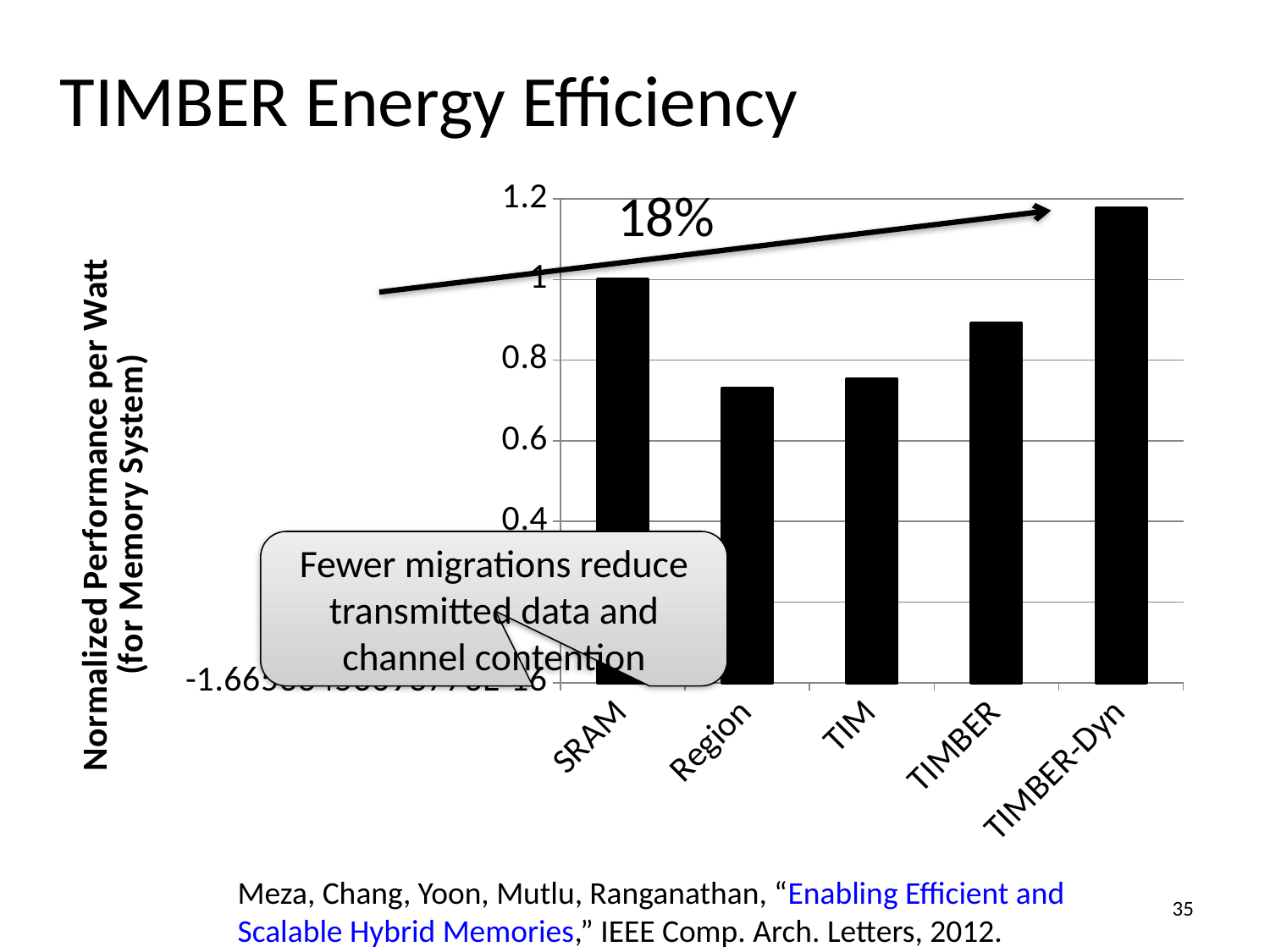
Is the value for Region greater or less than 0.8? less Which has a larger normalized performance per watt, TIM or TIMBER? TIMBER What kind of chart is shown on the slide? bar chart Which category has the highest normalized performance per watt? TIMBER-Dyn What is the normalized performance per watt for SRAM? 1 What percentage improvement is annotated by the arrow on the chart? 18% Is the value for TIMBER greater or less than 0.8? greater How many categories are plotted on the x axis? 5 Is the value for TIM greater or less than 0.8? less Which has a larger normalized performance per watt, SRAM or TIMBER-Dyn? TIMBER-Dyn What is the label of the y axis? Normalized Performance per Watt (for Memory System)